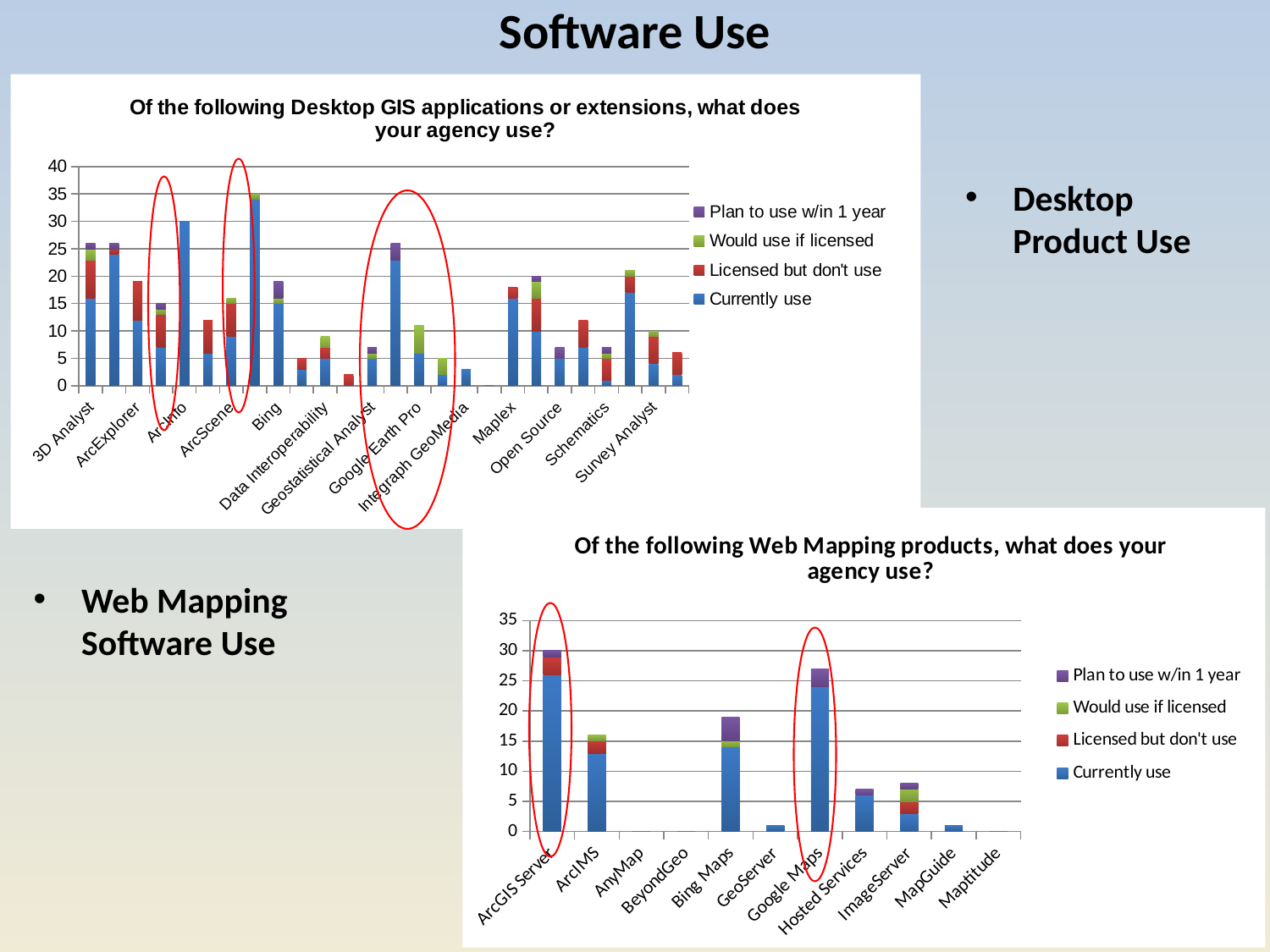
How many series does the legend list in the 'Of the following Desktop GIS applications or extensions, what does your agency use?' chart? 4 In the 'Of the following Web Mapping products, what does your agency use?' chart, which has the taller stacked bar, ArcGIS Server or Google Maps? ArcGIS Server In the 'Of the following Web Mapping products, what does your agency use?' chart, is the total bar for Hosted Services greater or less than 10? less What kind of chart is the 'Of the following Web Mapping products, what does your agency use?' chart? Stacked bar chart In the 'Of the following Web Mapping products, what does your agency use?' chart, which category has the tallest stacked bar? ArcGIS Server How many categories are shown on the x axis of the 'Of the following Web Mapping products, what does your agency use?' chart? 11 What is the title of the chart at the bottom of the slide? Of the following Web Mapping products, what does your agency use? In the 'Of the following Desktop GIS applications or extensions, what does your agency use?' chart, which legend entry is shown in blue? Currently use In the 'Of the following Web Mapping products, what does your agency use?' chart, is the total bar for ArcGIS Server greater or less than 25? greater In the 'Of the following Web Mapping products, what does your agency use?' chart, is the total bar for Bing Maps greater or less than 15? greater In the 'Of the following Web Mapping products, what does your agency use?' chart, which has the taller stacked bar, Bing Maps or ArcIMS? Bing Maps How many series does the legend list in the 'Of the following Web Mapping products, what does your agency use?' chart? 4